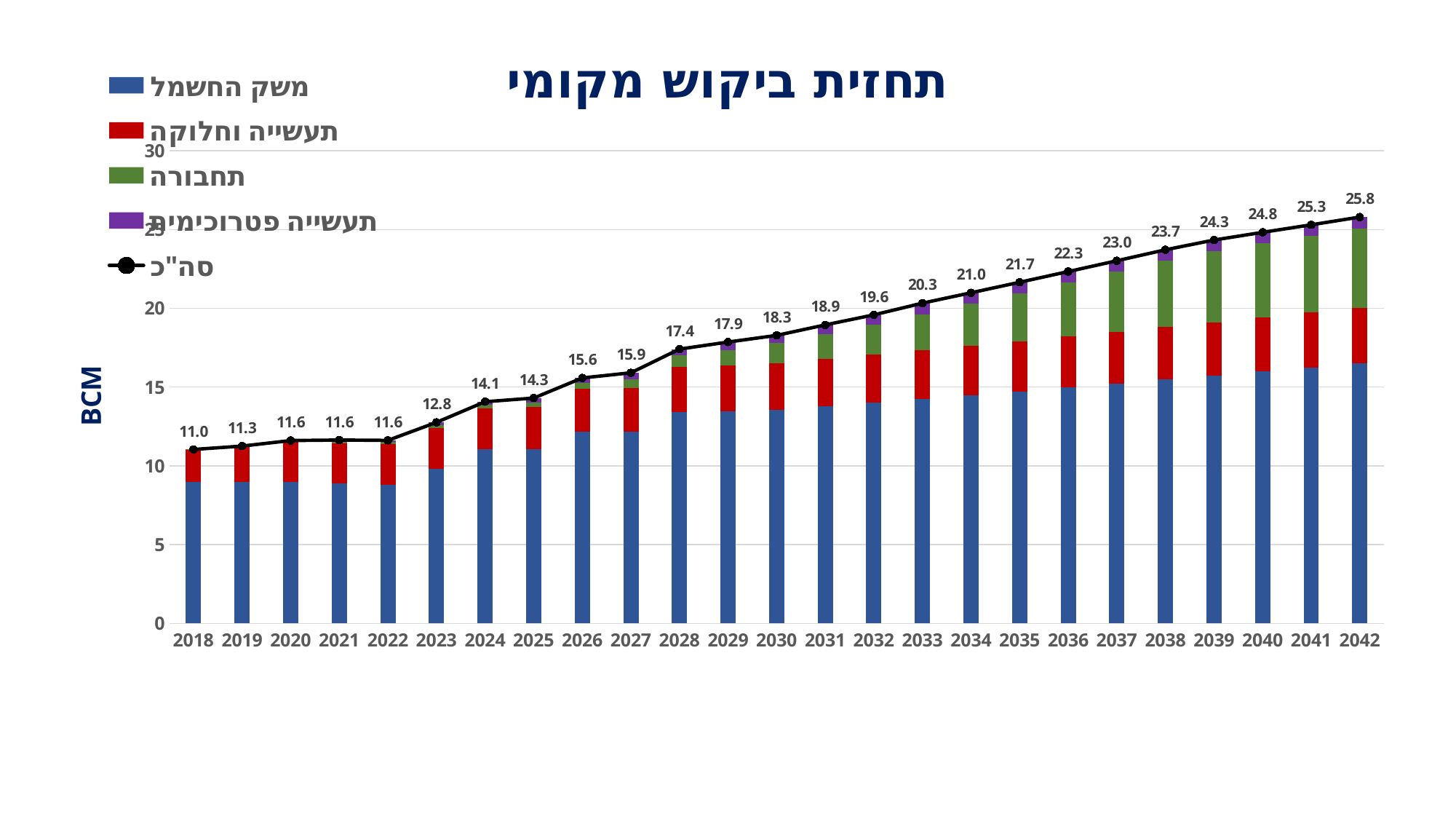
What is the total (סה"כ) value for 2030? 18.3 How many years are shown on the x axis? 25 Which year has the lowest total value? 2018 What is the total (סה"כ) value for 2042? 25.8 What is the total (סה"כ) value for 2018? 11.0 How many series does the legend list? 5 Is the value of the משק החשמל segment for 2042 greater or less than 15? greater What kind of chart is shown on the slide? Stacked bar chart with a line Which year has the highest total value? 2042 Do the total values rise or fall from 2018 to 2042? Rise Which year has a larger total, 2028 or 2035? 2035 What is the difference between the total for 2042 and the total for 2018? 14.8